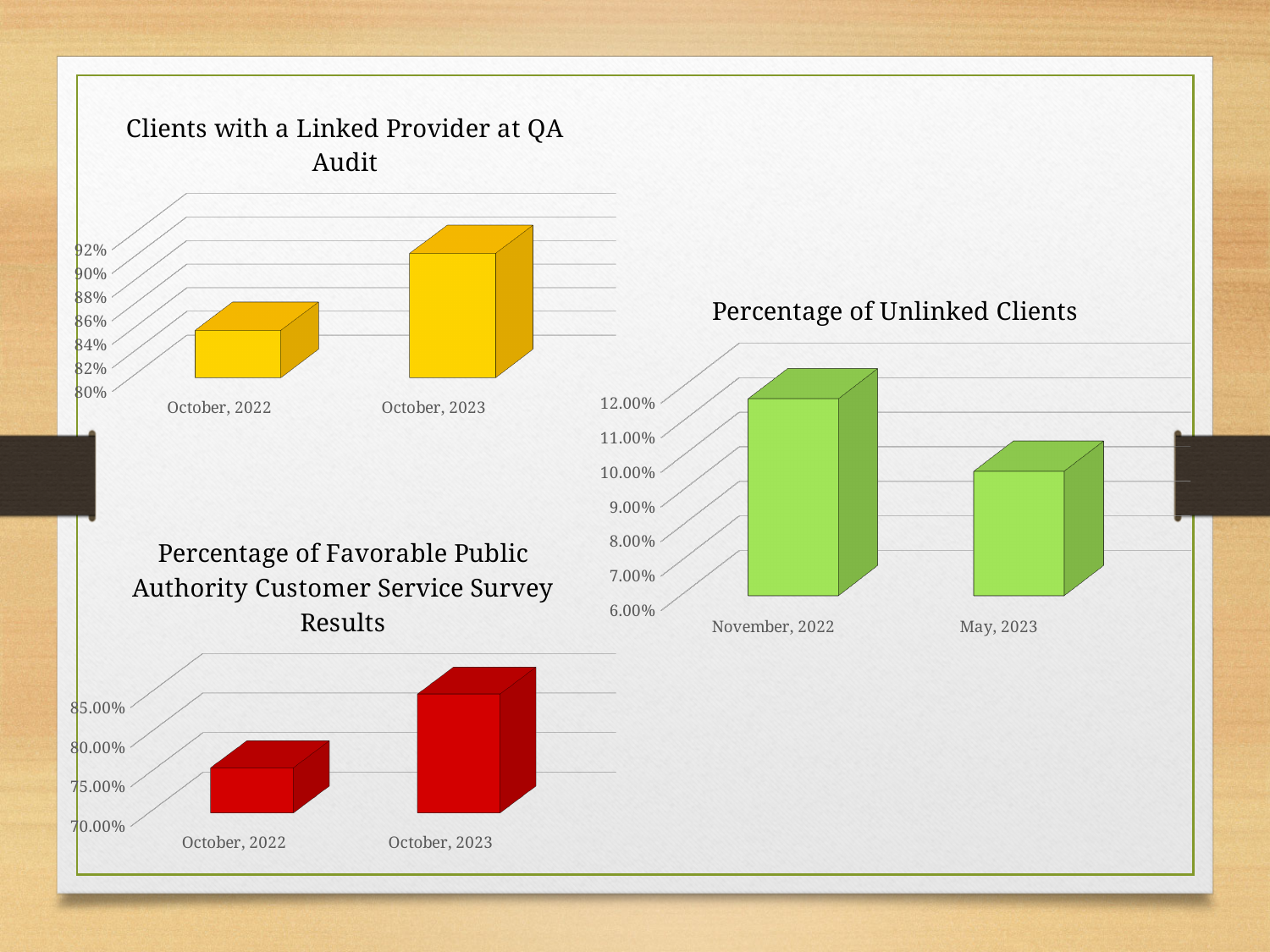
In the chart titled "Clients with a Linked Provider at QA Audit", how many categories are shown? 2 In the chart titled "Percentage of Favorable Public Authority Customer Service Survey Results", is the value for October, 2022 greater or less than 80.00%? less In the chart titled "Clients with a Linked Provider at QA Audit", is the value for October, 2023 greater or less than 88%? greater In the chart titled "Percentage of Unlinked Clients", is the value for November, 2022 greater or less than 11.00%? greater In the chart titled "Percentage of Favorable Public Authority Customer Service Survey Results", which is larger, the value for October, 2022 or October, 2023? October, 2023 What kind of chart is the chart titled "Percentage of Favorable Public Authority Customer Service Survey Results"? bar chart In the chart titled "Clients with a Linked Provider at QA Audit", which category has the higher value? October, 2023 How many charts are shown on the slide? 3 In the chart titled "Percentage of Unlinked Clients", which category has the lower value? May, 2023 In the chart titled "Percentage of Unlinked Clients", do the values rise or fall from November, 2022 to May, 2023? fall